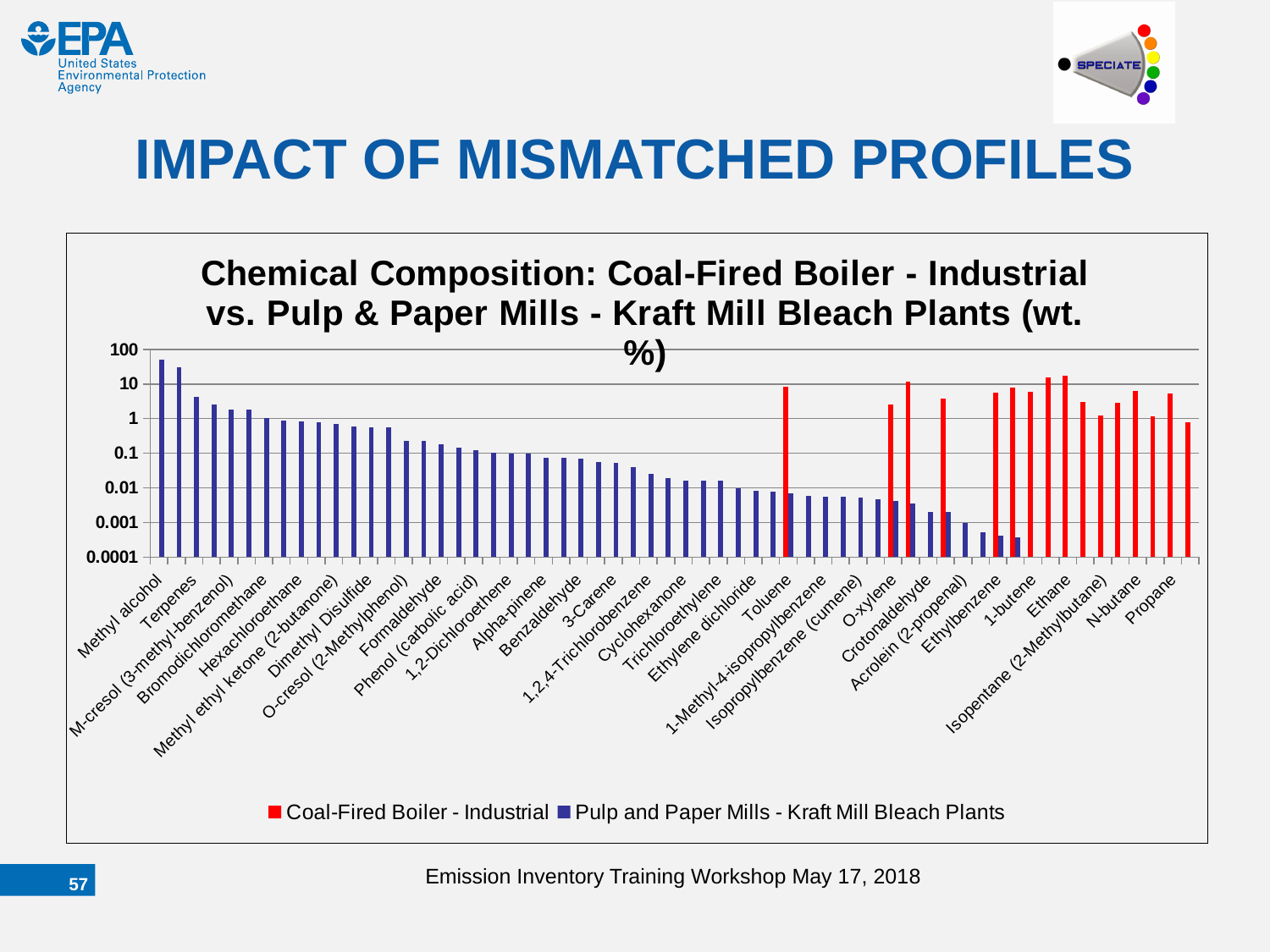
Which is larger in the Coal-Fired Boiler series, Ethane or Propane? Ethane Is the value for Ethane in the Coal-Fired Boiler series greater or less than 10? greater Do the Pulp and Paper Mills values generally rise or fall from left to right along the x axis? fall Which series is shown in red in the chart? Coal-Fired Boiler - Industrial Is the value for Dimethyl Disulfide in the Pulp and Paper Mills series greater or less than 1? less Is the value for Methyl alcohol in the Pulp and Paper Mills series greater or less than 10? greater Which series is shown in blue in the chart? Pulp and Paper Mills - Kraft Mill Bleach Plants What kind of chart is shown on the slide? bar chart Which chemical has the highest value in the Pulp and Paper Mills series? Methyl alcohol How many series does the chart legend list? 2